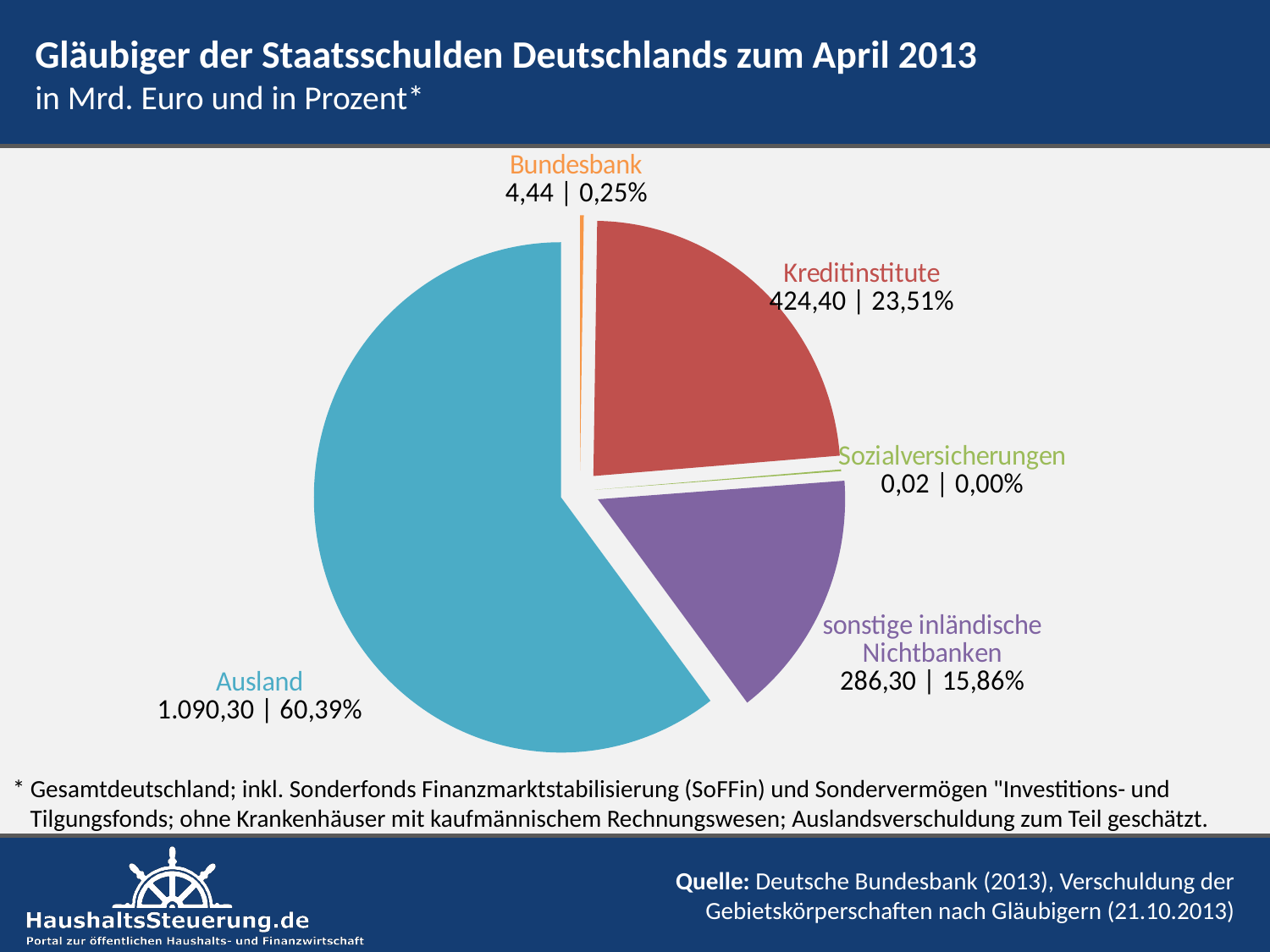
What kind of chart is shown on the slide? pie chart What is the difference in Mrd. Euro between Kreditinstitute and sonstige inländische Nichtbanken? 138,10 Which category has the smallest share of the pie? Sozialversicherungen What is the value in Mrd. Euro for Ausland? 1.090,30 Which is larger, the value for Kreditinstitute or the value for sonstige inländische Nichtbanken? Kreditinstitute What is the value in Mrd. Euro for sonstige inländische Nichtbanken? 286,30 What percentage share does Bundesbank hold? 0,25% How many slices does the pie chart have? 5 What colour is the Ausland slice? blue What percentage share does Kreditinstitute hold? 23,51% What is the value in Mrd. Euro for Sozialversicherungen? 0,02 Which category has the largest share of the pie? Ausland